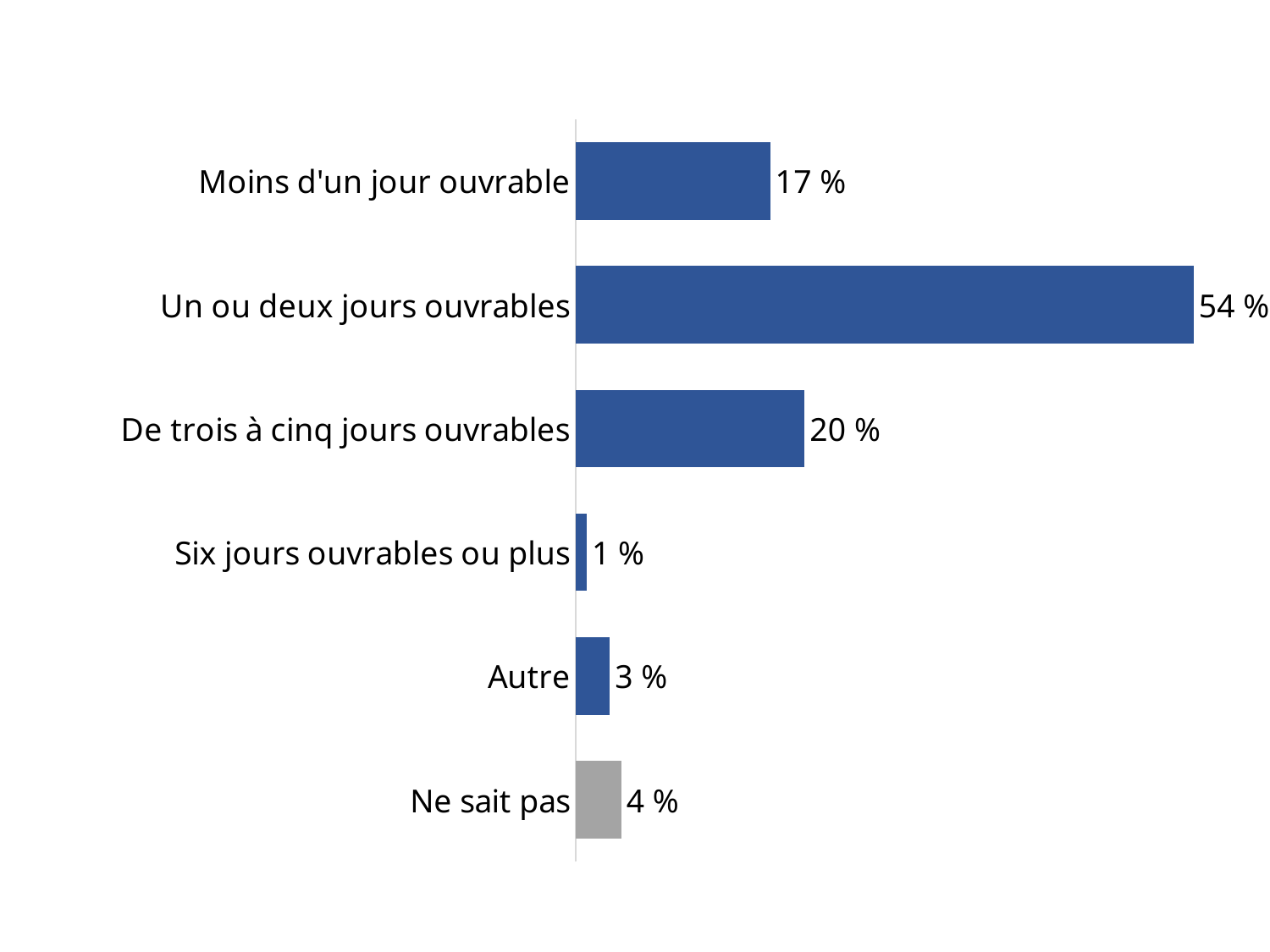
Which category's bar is coloured grey rather than blue? Ne sait pas Which category has the lowest value? Six jours ouvrables ou plus Which category has the highest value? Un ou deux jours ouvrables What is the value for "Moins d'un jour ouvrable"? 17 % What is the difference between the values for "Un ou deux jours ouvrables" and "De trois à cinq jours ouvrables"? 34 % How many categories are shown in the chart? 6 What is the value for "Un ou deux jours ouvrables"? 54 % What is the value for "De trois à cinq jours ouvrables"? 20 % What is the difference between the values for "Ne sait pas" and "Autre"? 1 % What kind of chart is shown on the slide? Bar chart What is the value for "Ne sait pas"? 4 % Which is larger, the value for "Moins d'un jour ouvrable" or the value for "De trois à cinq jours ouvrables"? De trois à cinq jours ouvrables